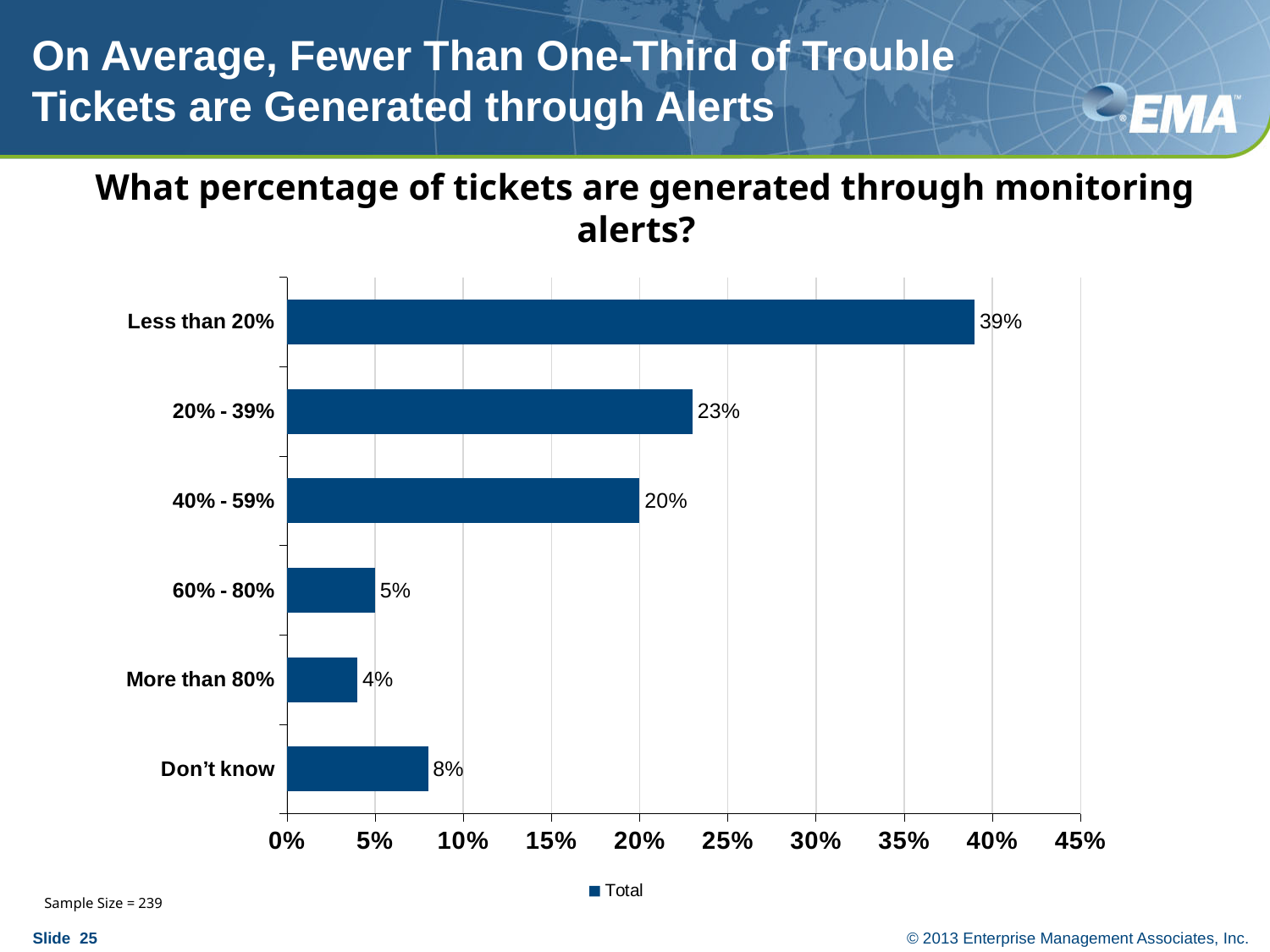
What is the difference between the values for "Less than 20%" and "20% - 39%"? 16% Which category has the highest value? Less than 20% Is the value for "20% - 39%" greater or less than 25%? less What kind of chart is shown on the slide? bar chart How many categories are shown in the chart? 6 How many series does the legend list? 1 What is the value for the "Don't know" category? 8% What is the title of the chart? What percentage of tickets are generated through monitoring alerts? Which is larger, the value for "60% - 80%" or the value for "Don't know"? Don't know What is the value for the "40% - 59%" category? 20% What is the value for the "Less than 20%" category? 39% Which category has the lowest value? More than 80%